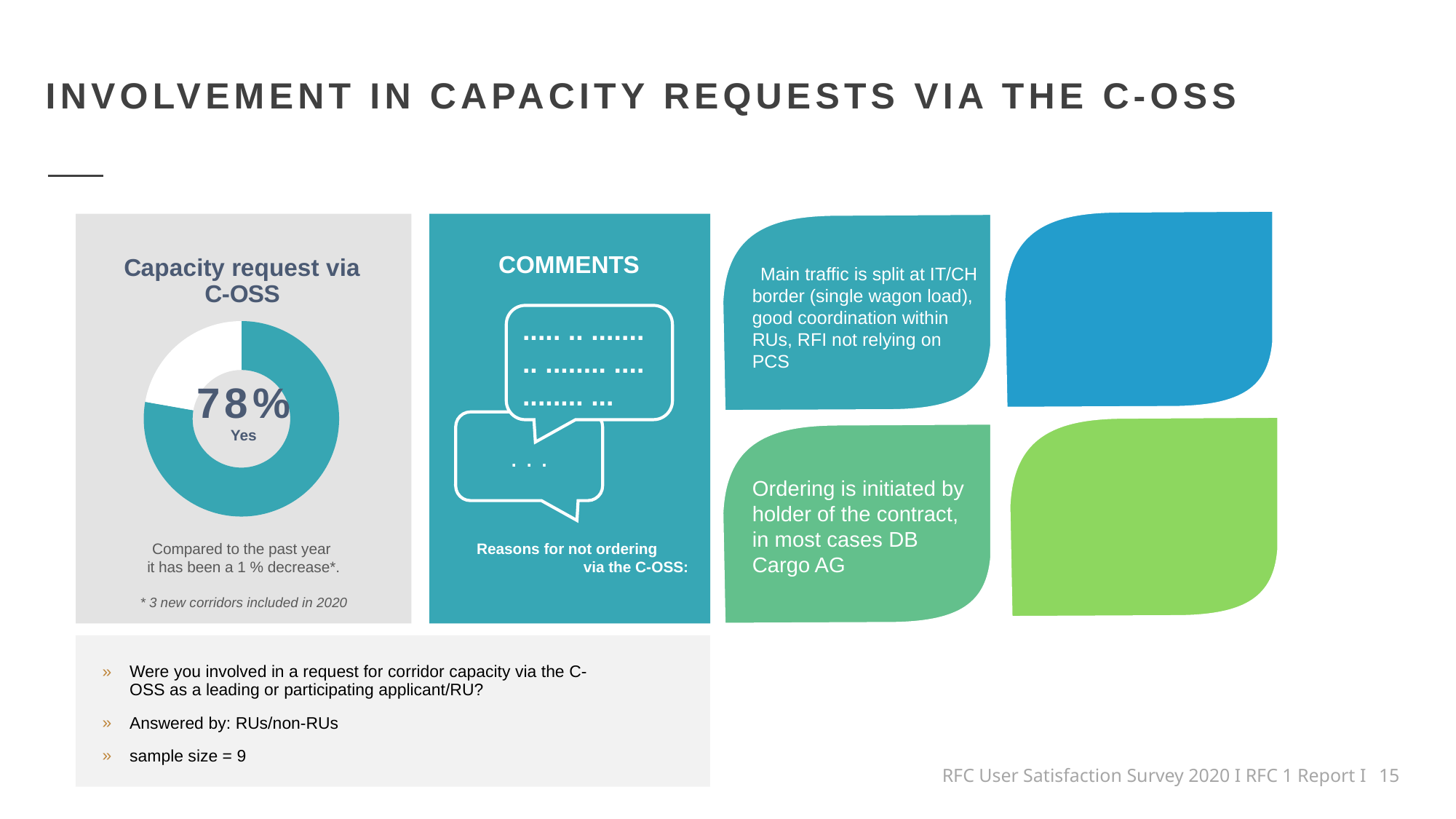
Is the Yes share in the Capacity request via C-OSS chart greater or less than 50%? greater What is the sample size for the Capacity request via C-OSS chart? 9 How many new corridors were included in 2020 according to the footnote under the chart? 3 What is the title of the chart on the slide? Capacity request via C-OSS What percentage of respondents answered Yes in the Capacity request via C-OSS chart? 78% Which label is printed in the centre of the donut chart? 78% Yes According to the text under the chart, how has the Yes share changed compared to the past year? A 1 % decrease Which response makes up the larger portion of the Capacity request via C-OSS donut chart, Yes or the remaining portion? Yes What kind of chart is used to show the Capacity request via C-OSS result? Donut (pie) chart